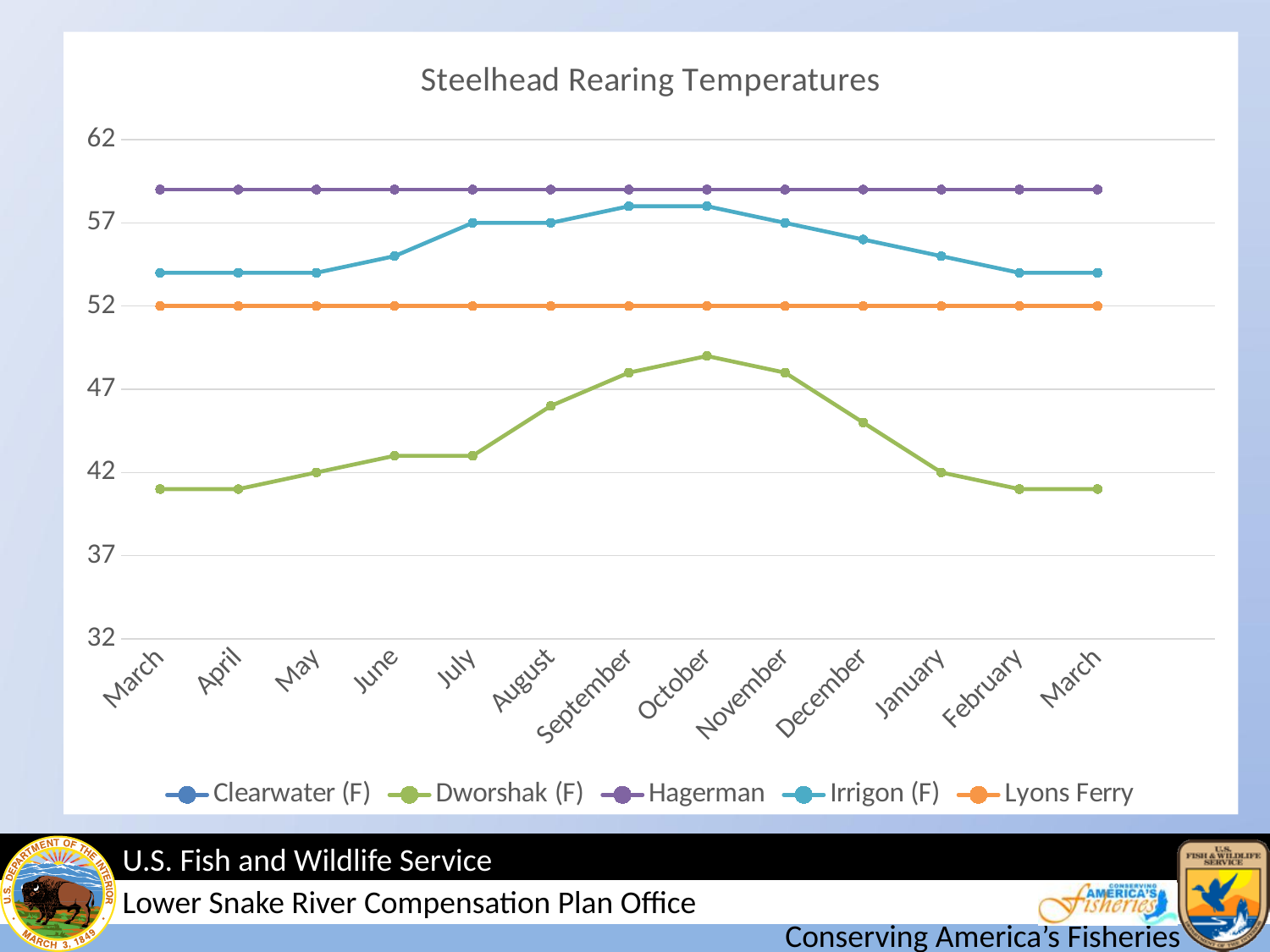
In October, which is larger, the Irrigon (F) value or the Dworshak (F) value? Irrigon (F) Is the value for Hagerman in October greater or less than 57? greater Is the value for Dworshak (F) in October greater or less than 47? greater Does the Dworshak (F) line rise or fall from March to October? rise What is the value for Lyons Ferry in October? 52 What kind of chart is shown on the slide? line chart In which month is the Dworshak (F) value highest? October How many months are plotted along the x axis? 13 What is the value for Dworshak (F) in May? 42 What is the value for Irrigon (F) in July? 57 How many series does the legend list? 5 What is the title of the chart? Steelhead Rearing Temperatures